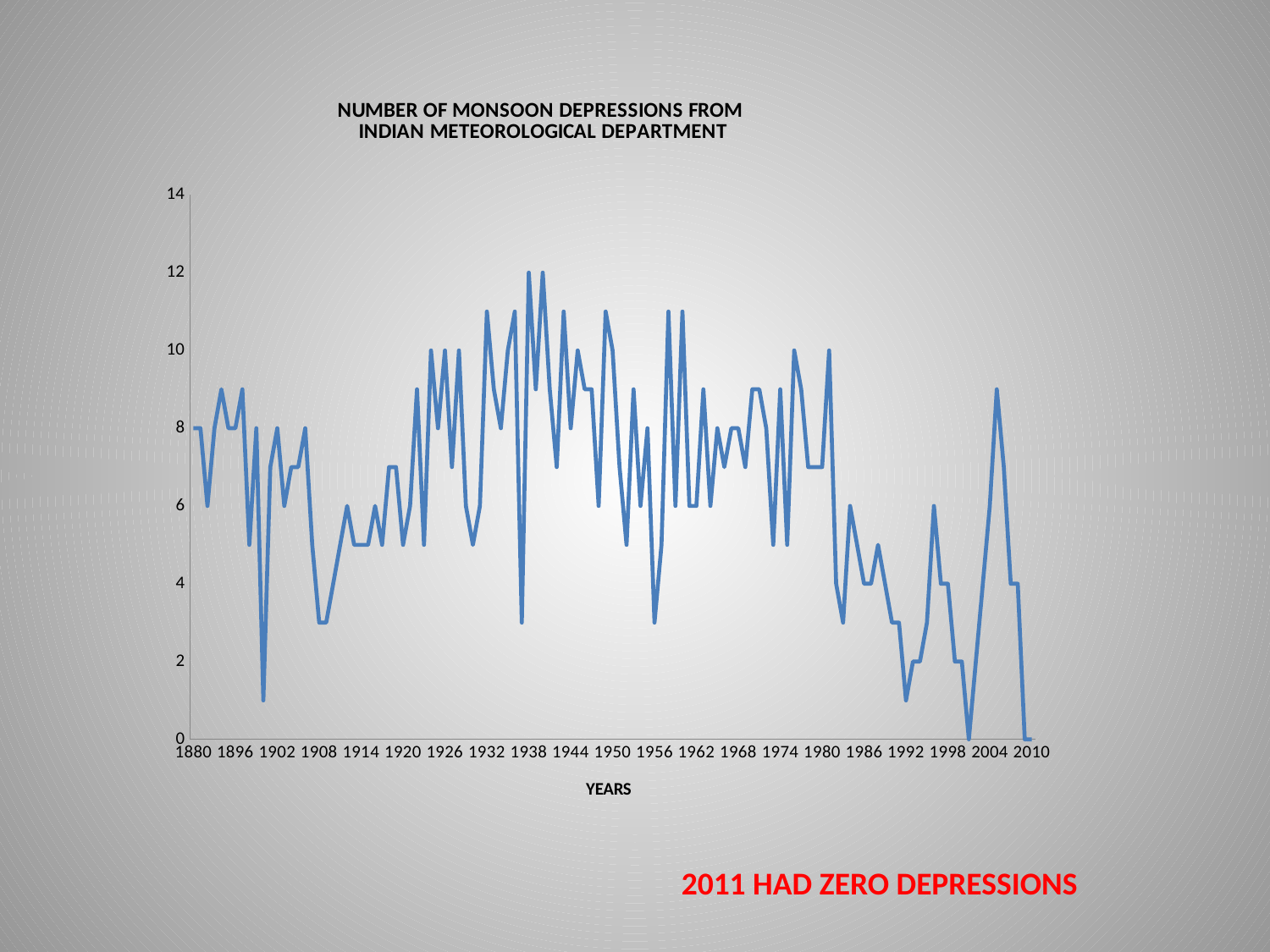
Does the number of monsoon depressions generally rise or fall between 1980 and 2010? fall What is the title of the chart? NUMBER OF MONSOON DEPRESSIONS FROM INDIAN METEOROLOGICAL DEPARTMENT What is the highest number of monsoon depressions reached by the line in the chart? 12 What is the label on the x axis of the chart? YEARS What is the maximum value shown on the y axis of the chart? 14 According to the slide, how many depressions did 2011 have? zero Is the value for 1992 greater or less than 4? less What is the lowest number of monsoon depressions reached by the line in the chart? 0 How many data series are plotted in the chart? 1 What kind of chart is shown on the slide? line chart Is the value for 1880 greater or less than 6? greater Is the value for 2010 greater or less than 2? less